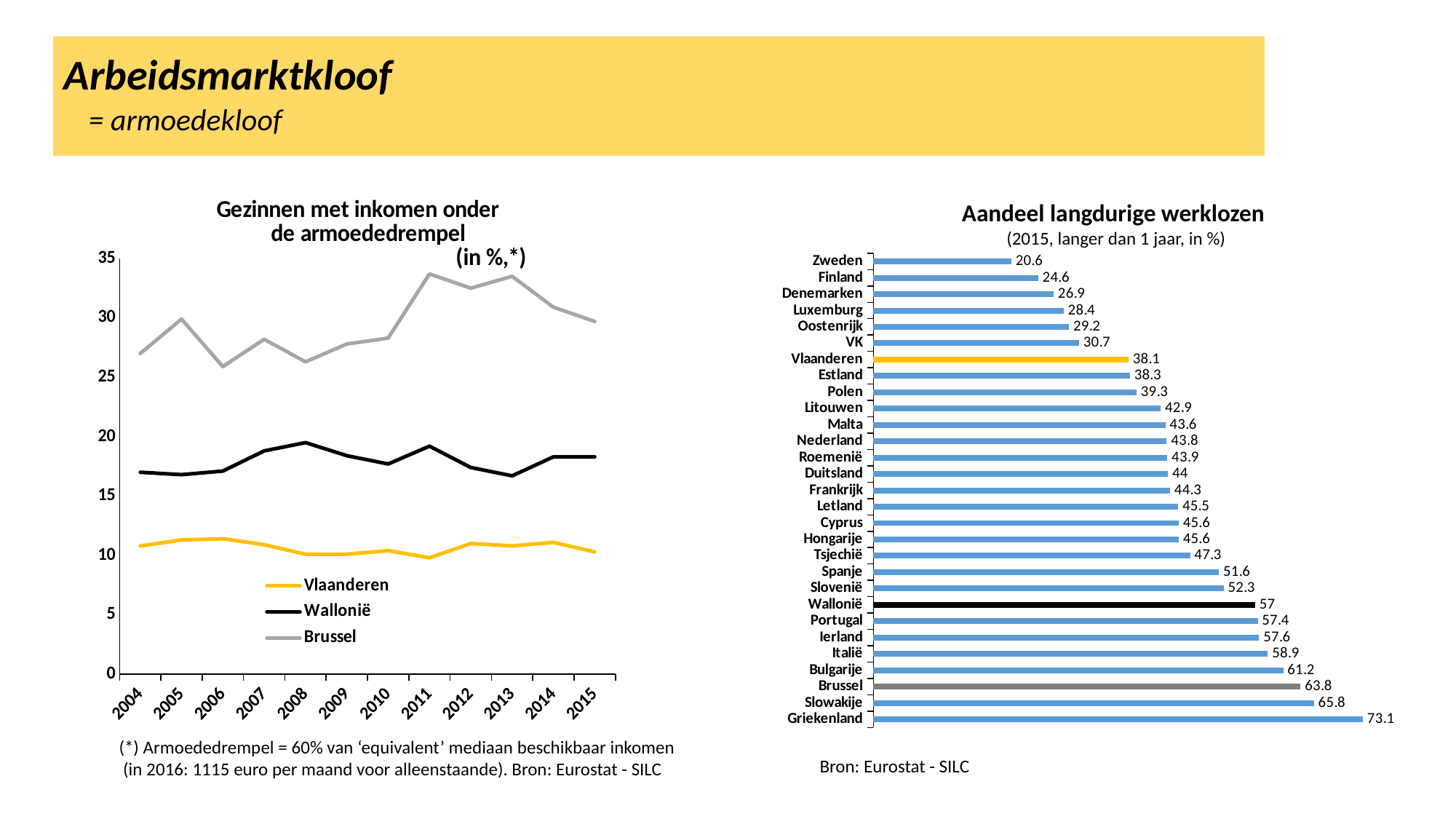
In the chart 'Aandeel langdurige werklozen', what is the value for Vlaanderen? 38.1 In the chart 'Aandeel langdurige werklozen', which is larger, the value for Portugal or the value for Slovenië? Portugal How many series does the legend of the chart 'Gezinnen met inkomen onder de armoededrempel' list? 3 In the chart 'Gezinnen met inkomen onder de armoededrempel', which series has the higher value in 2015, Wallonië or Vlaanderen? Wallonië How many years are shown on the x axis of the chart 'Gezinnen met inkomen onder de armoededrempel'? 12 In the chart 'Gezinnen met inkomen onder de armoededrempel', is the value for Brussel in 2011 greater or less than 30? greater In the chart 'Aandeel langdurige werklozen', what is the difference between the values for Brussel and Vlaanderen? 25.7 In the chart 'Aandeel langdurige werklozen', what is the value for Wallonië? 57 In the chart 'Aandeel langdurige werklozen', which country has the lowest value? Zweden What kind of chart is 'Gezinnen met inkomen onder de armoededrempel'? line chart In the chart 'Aandeel langdurige werklozen', how many countries or regions are shown? 29 In the chart 'Aandeel langdurige werklozen', which country has the highest value? Griekenland